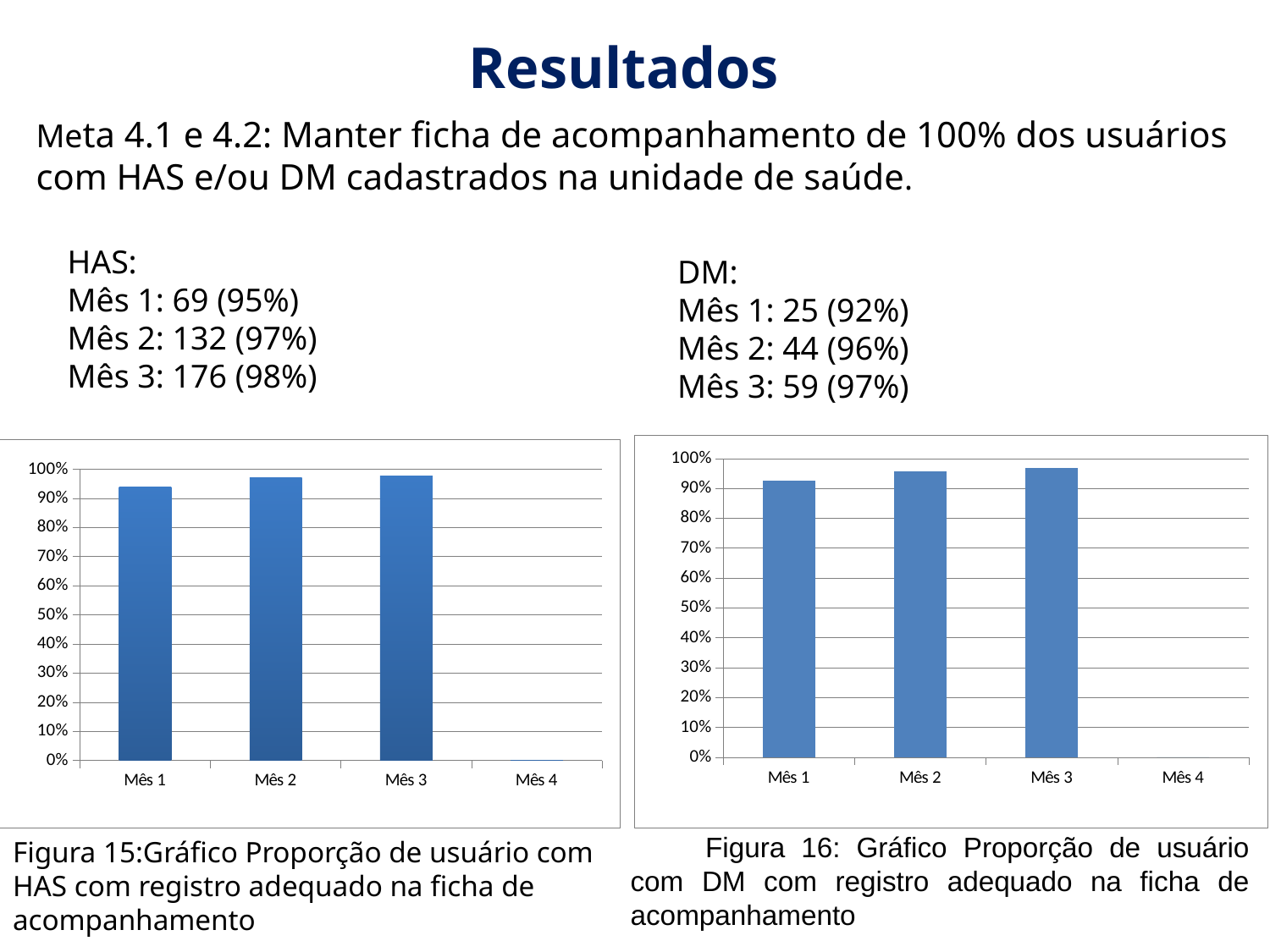
What is the difference between the DM percentages for Mês 2 and Mês 1 shown on the slide? 4% In the Figura 16 chart (DM), is the value for Mês 3 greater or less than 100%? less In the Figura 16 chart (DM), do the values rise or fall from Mês 1 to Mês 3? rise According to the slide, what is the percentage for Mês 3 in the HAS chart (Figura 15)? 98% In the Figura 15 chart (HAS), is the value for Mês 1 greater or less than 90%? greater In the Figura 16 chart (DM), is the value for Mês 1 greater or less than 90%? greater In the Figura 15 chart (HAS), which is larger, the value for Mês 1 or the value for Mês 3? Mês 3 What type of chart is Figura 15 on the left of the slide? bar chart In the Figura 15 chart (HAS), which month has the lowest value? Mês 4 In the Figura 16 chart (DM), which month has the highest value? Mês 3 According to the slide, what is the percentage for Mês 1 in the DM chart (Figura 16)? 92% How many categories are shown on the x axis of the Figura 16 chart on the right? 4